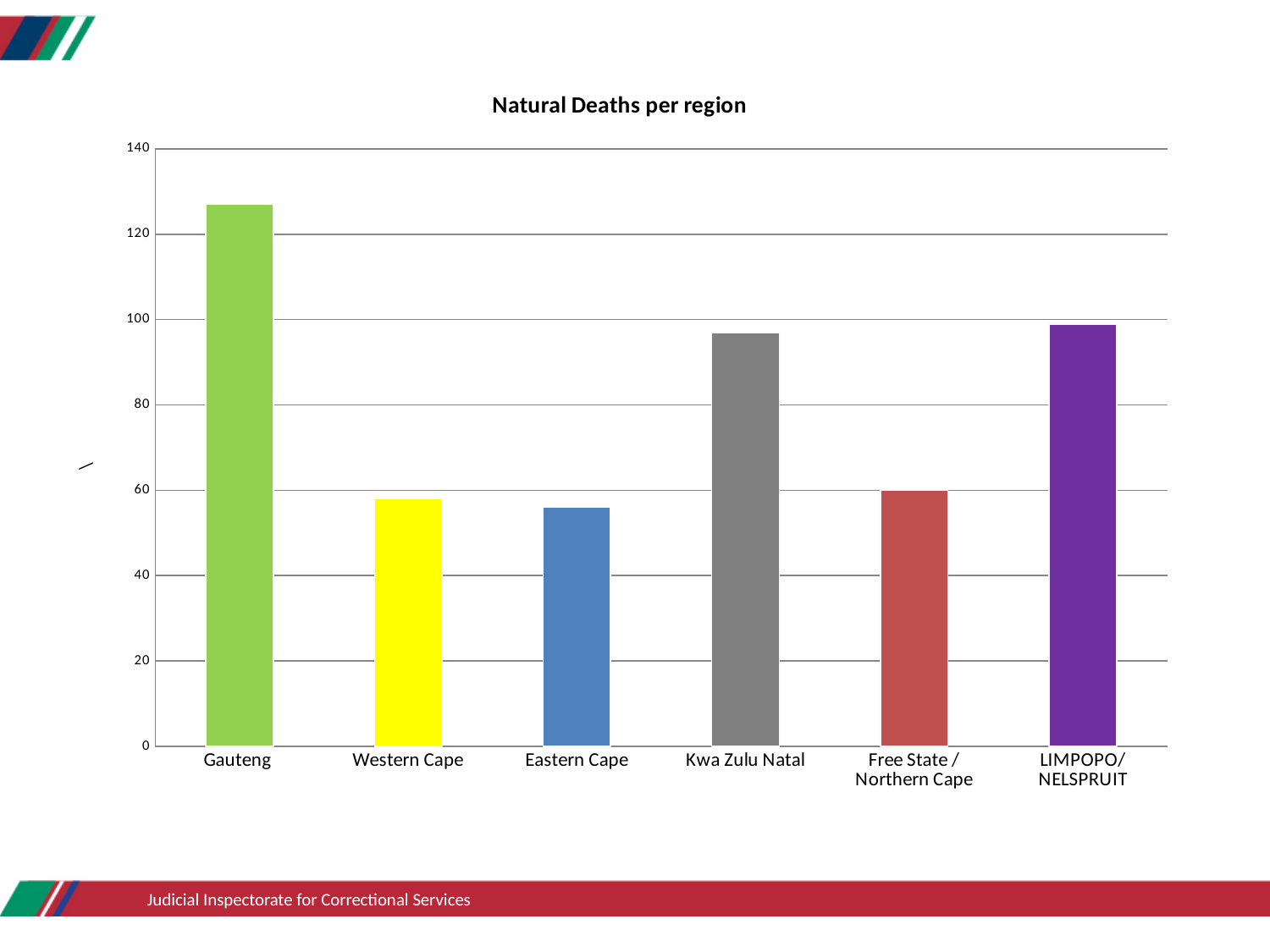
How many regions are shown on the x axis of the chart? 6 Which is larger, the value for Gauteng or the value for Kwa Zulu Natal? Gauteng What colour is the bar for Gauteng? green Which region has the highest number of natural deaths? Gauteng What kind of chart is shown on the slide? bar chart Is the value for Eastern Cape greater or less than 60? less Is the value for Gauteng greater or less than 120? greater What is the title of the chart? Natural Deaths per region Is the value for LIMPOPO/NELSPRUIT greater or less than 80? greater